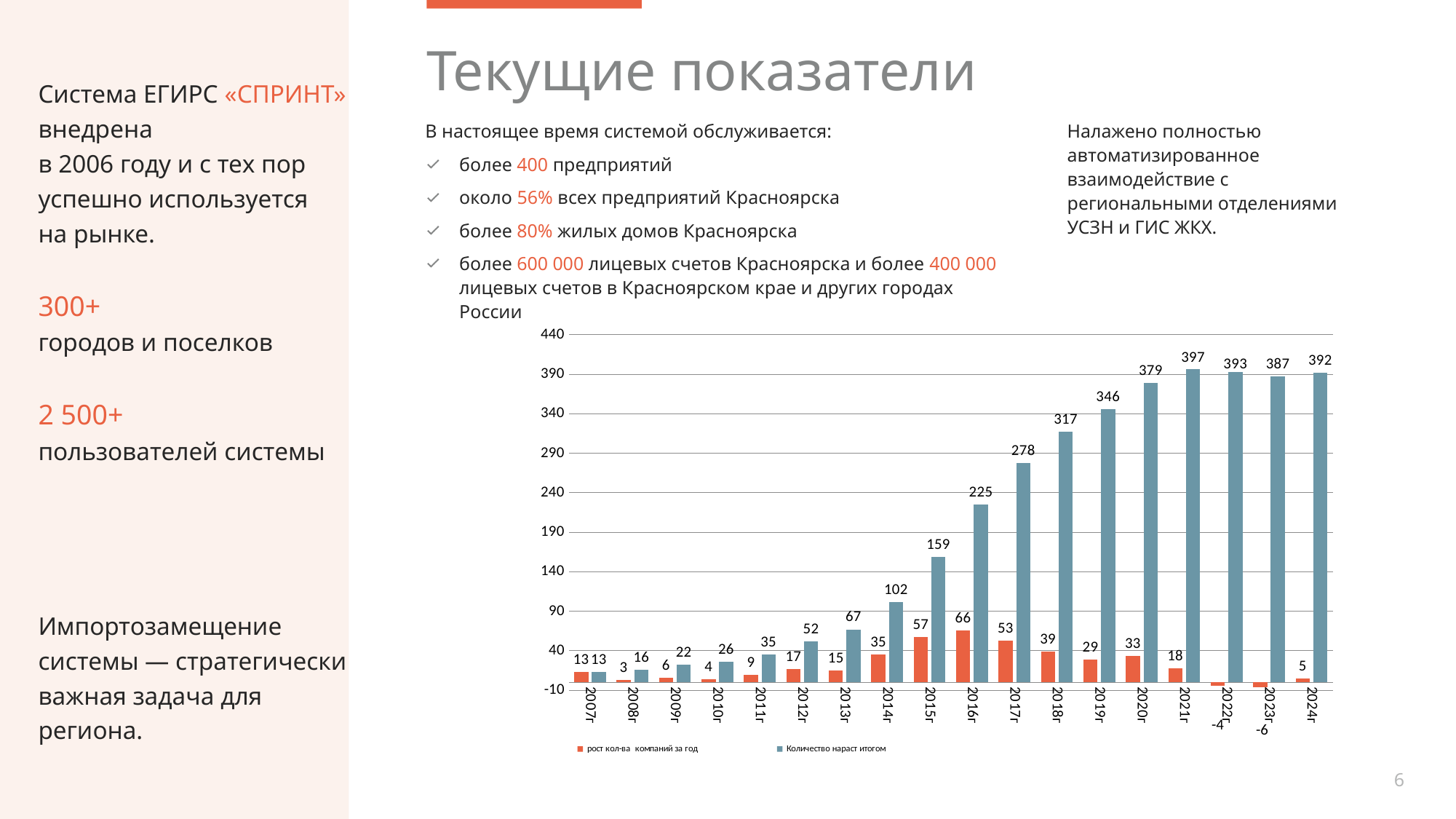
In which year is "рост кол-ва компаний за год" lowest? 2023г What is the difference between "Количество нараст итогом" in 2021г and in 2020г? 18 Which is larger: "рост кол-ва компаний за год" in 2017г or in 2018г? 2017г How many series does the chart legend list? 2 What is the value of "рост кол-ва компаний за год" for 2023г? -6 What is the value of "Количество нараст итогом" for 2016г? 225 What type of chart is shown on the slide? bar chart In which year is "Количество нараст итогом" highest? 2021г How many years (categories) are shown on the x axis of the chart? 18 What is the value of "рост кол-ва компаний за год" for 2015г? 57 In which year is "рост кол-ва компаний за год" highest? 2016г Does "Количество нараст итогом" generally rise or fall from 2007г to 2021г? rise